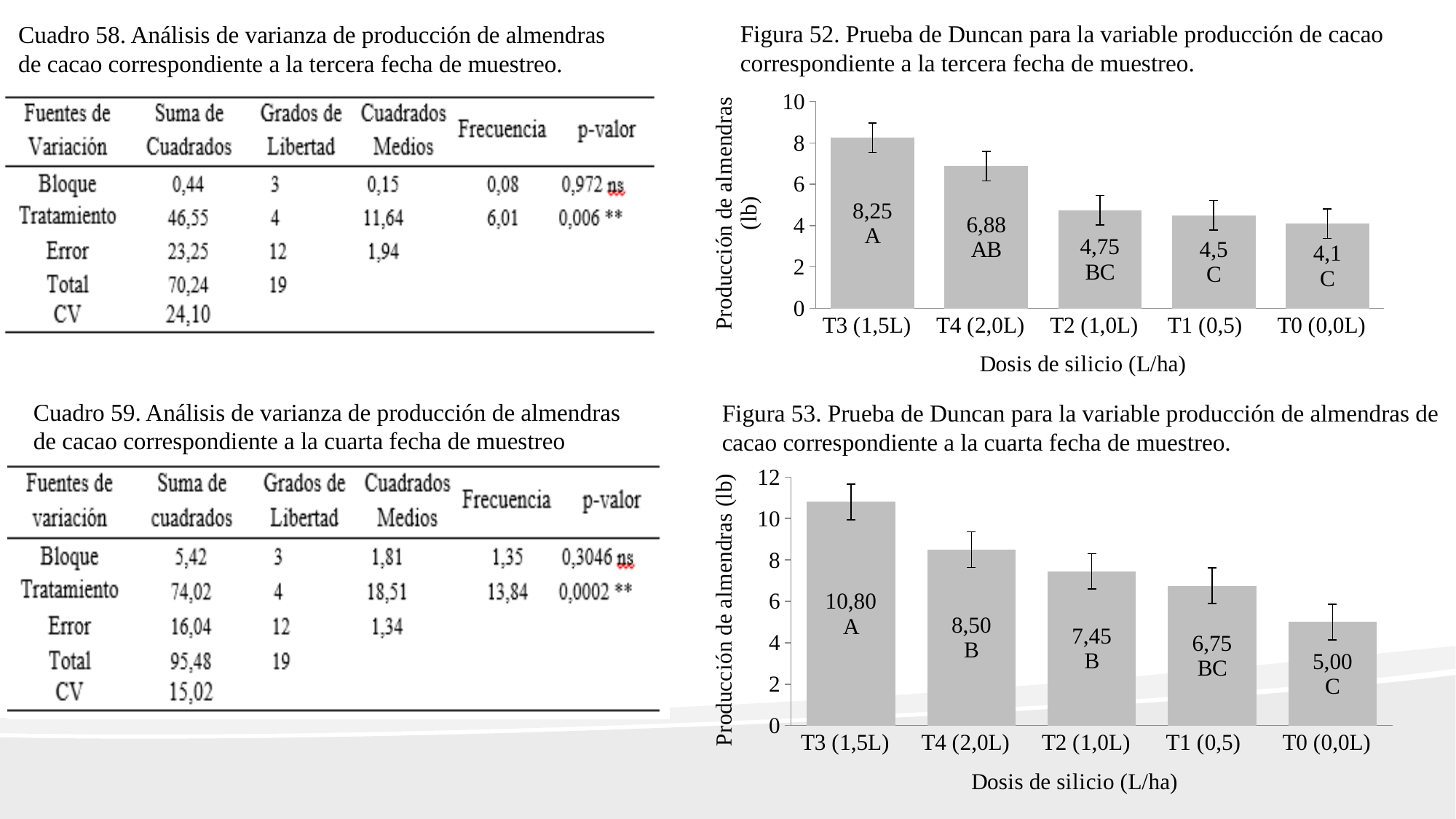
What kind of chart is Figura 53 (bottom chart)? bar chart In Figura 52 (top chart), which category has the lowest production? T0 (0,0L) In Figura 52 (top chart), do the values rise or fall from left to right along the x axis? fall In Figura 53 (bottom chart), what is the difference between T3 (1,5L) and T0 (0,0L)? 5,80 In Figura 53 (bottom chart), what is the value for T2 (1,0L)? 7,45 What is the x-axis title of Figura 52 (top chart)? Dosis de silicio (L/ha) In Figura 53 (bottom chart), which category has the highest production? T3 (1,5L) In Figura 52 (top chart), what is the difference between T3 (1,5L) and T4 (2,0L)? 1,37 In Figura 53 (bottom chart), is the value for T3 (1,5L) greater or less than 10? greater In Figura 52 (top chart), what is the value for T3 (1,5L)? 8,25 In Figura 53 (bottom chart), which is larger, the value for T4 (2,0L) or T1 (0,5)? T4 (2,0L) In Figura 52 (top chart), how many bars are plotted? 5